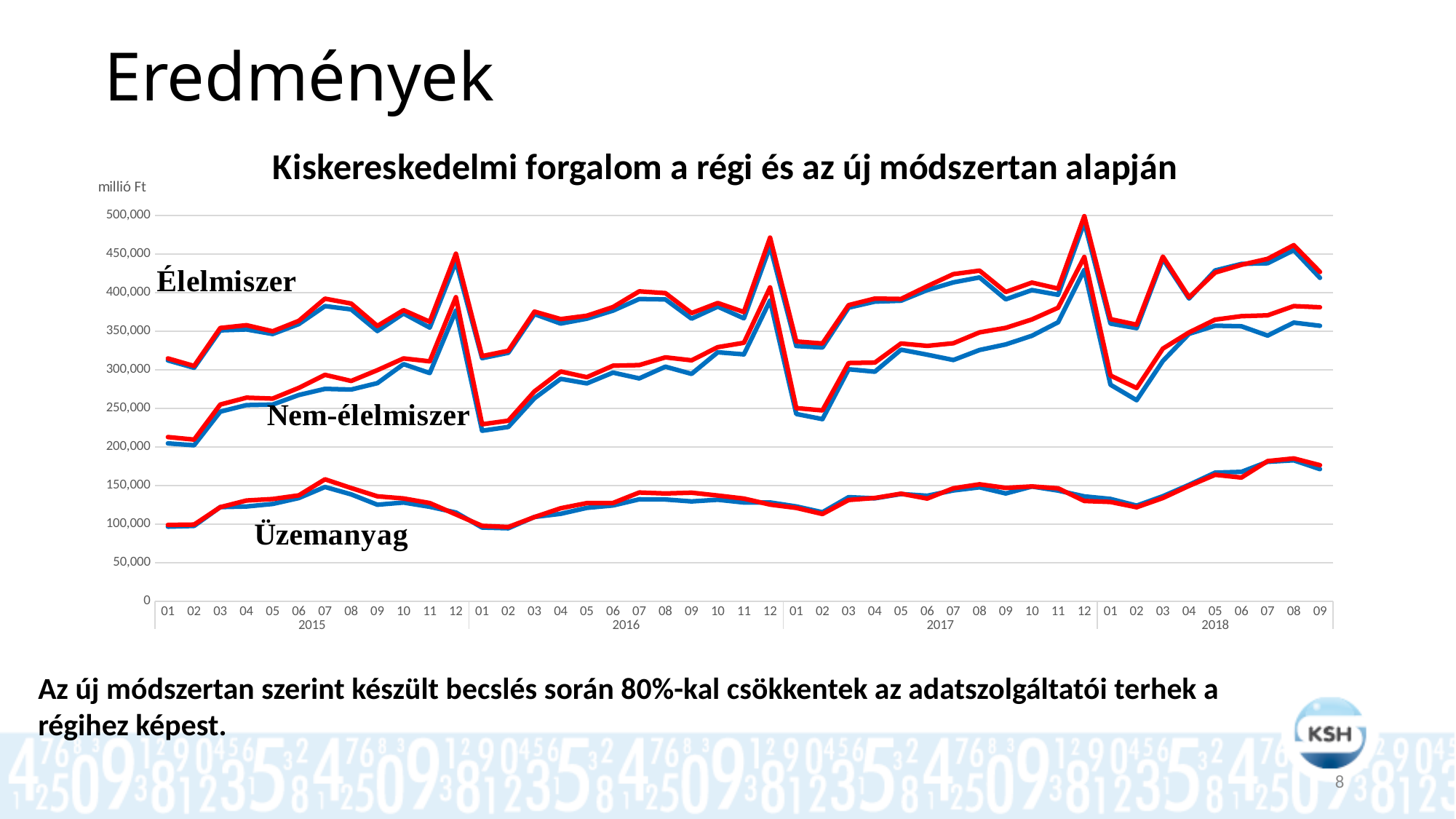
Is the value for Nem-élelmiszer in month 01 of 2016 greater or less than 250,000? less What kind of chart is shown on the slide? line chart Do the Élelmiszer values generally rise or fall from 2015 to 2018? rise Which of the three labelled groups (Élelmiszer, Nem-élelmiszer, Üzemanyag) has the highest values throughout the chart? Élelmiszer How many monthly data points are plotted along the x axis (from 01 2015 to 09 2018)? 45 How many years are shown along the x axis of the chart? 4 What is the title of the chart? Kiskereskedelmi forgalom a régi és az új módszertan alapján Which of the three labelled groups (Élelmiszer, Nem-élelmiszer, Üzemanyag) has the lowest values throughout the chart? Üzemanyag Is the value for Élelmiszer in month 01 of 2015 greater or less than 250,000? greater What unit is shown on the vertical axis of the chart? millió Ft Is the value for Üzemanyag in month 07 of 2015 greater or less than 100,000? greater